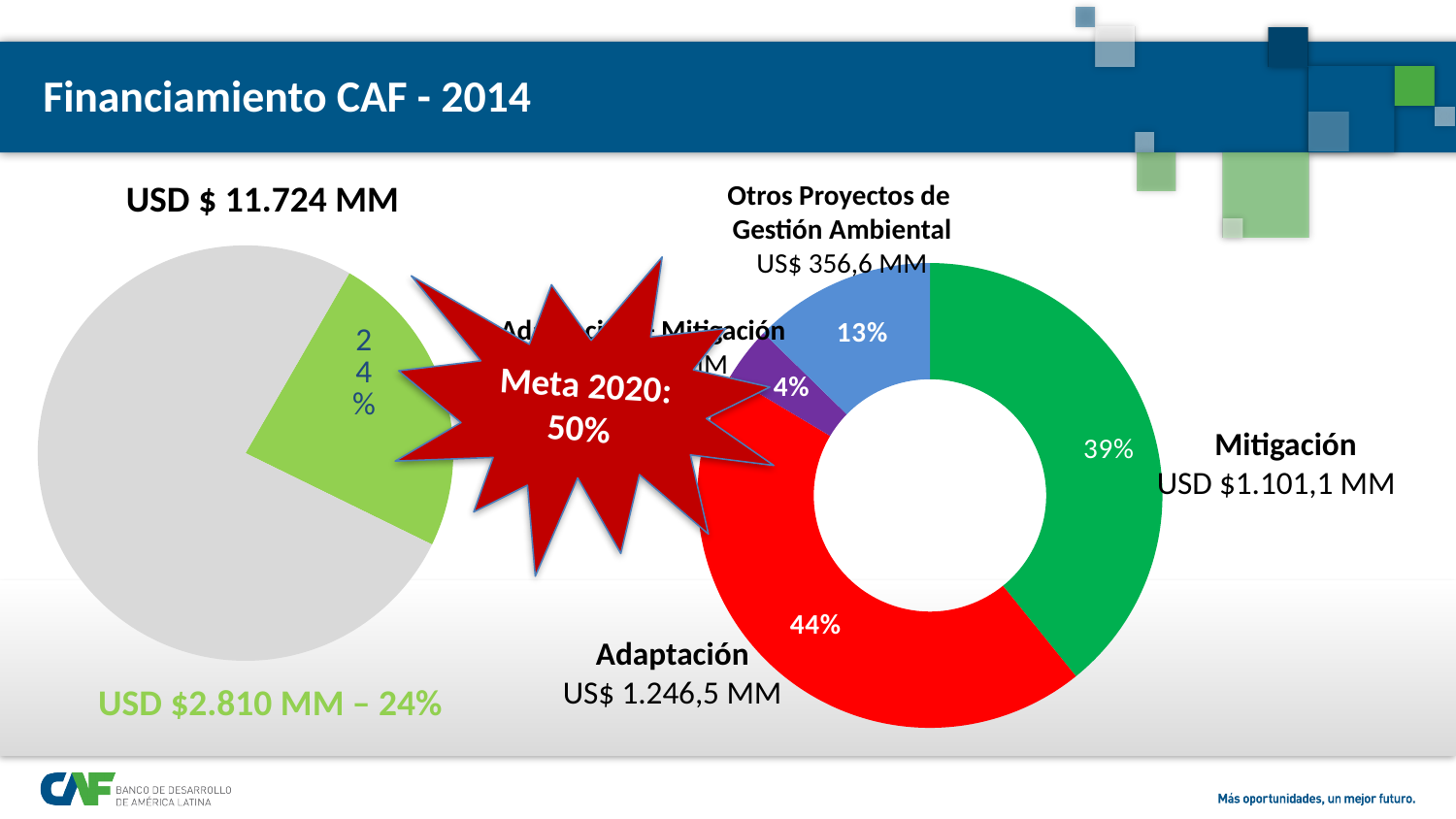
On the donut chart on the right, what is the difference in percentage points between Adaptación and Mitigación? 5 On the donut chart on the right, what amount is shown for Adaptación? US$ 1.246,5 MM On the donut chart on the right, which segment has the largest share? Adaptación On the donut chart on the right, what amount is shown for Mitigación? USD $1.101,1 MM On the donut chart on the right, what percentage is shown for Adaptación? 44% What kind of chart is shown on the left side of the slide? Pie chart On the donut chart on the right, what is the smallest percentage shown on any segment? 4% On the pie chart on the left, what amount is shown for the green slice? USD $2.810 MM On the donut chart on the right, which is larger, the share for Mitigación or the share for Otros Proyectos de Gestión Ambiental? Mitigación On the donut chart on the right, what amount is shown for Otros Proyectos de Gestión Ambiental? US$ 356,6 MM On the donut chart on the right, what percentage is shown for Mitigación? 39% On the pie chart on the left, what percentage does the green slice represent? 24%